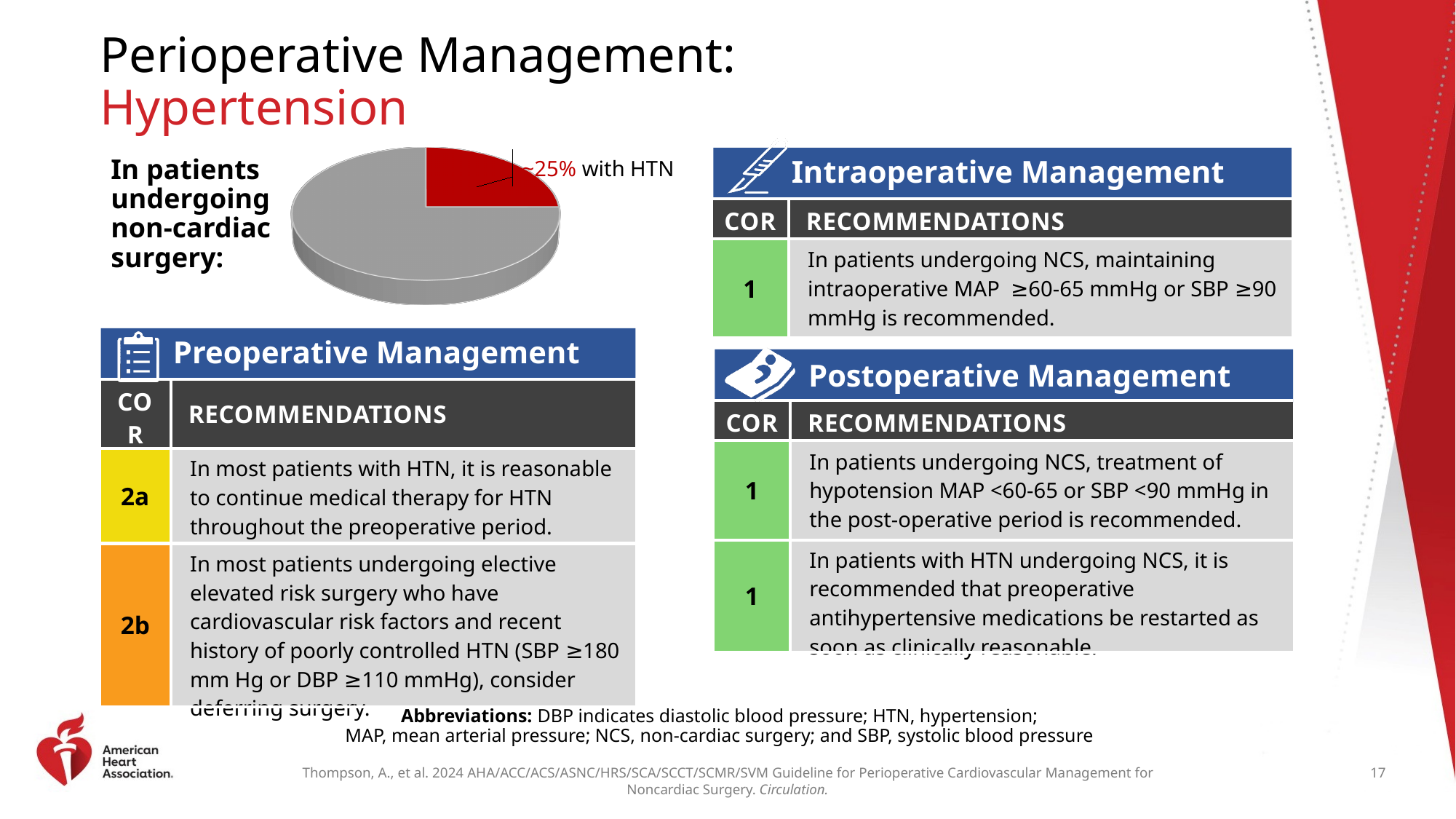
What text labels the red slice of the pie chart? ~25% with HTN What kind of chart is shown on the left of the slide next to the text 'In patients undergoing non-cardiac surgery'? Pie chart Is the red (HTN) slice of the pie chart larger or smaller than the gray slice? Smaller Which slice of the pie chart is the largest, the red one or the gray one? The gray one How many slices does the pie chart have? 2 What colour is the pie slice representing patients with HTN? Red Is the share of the pie chart taken by the red HTN slice greater or less than 50%? Less